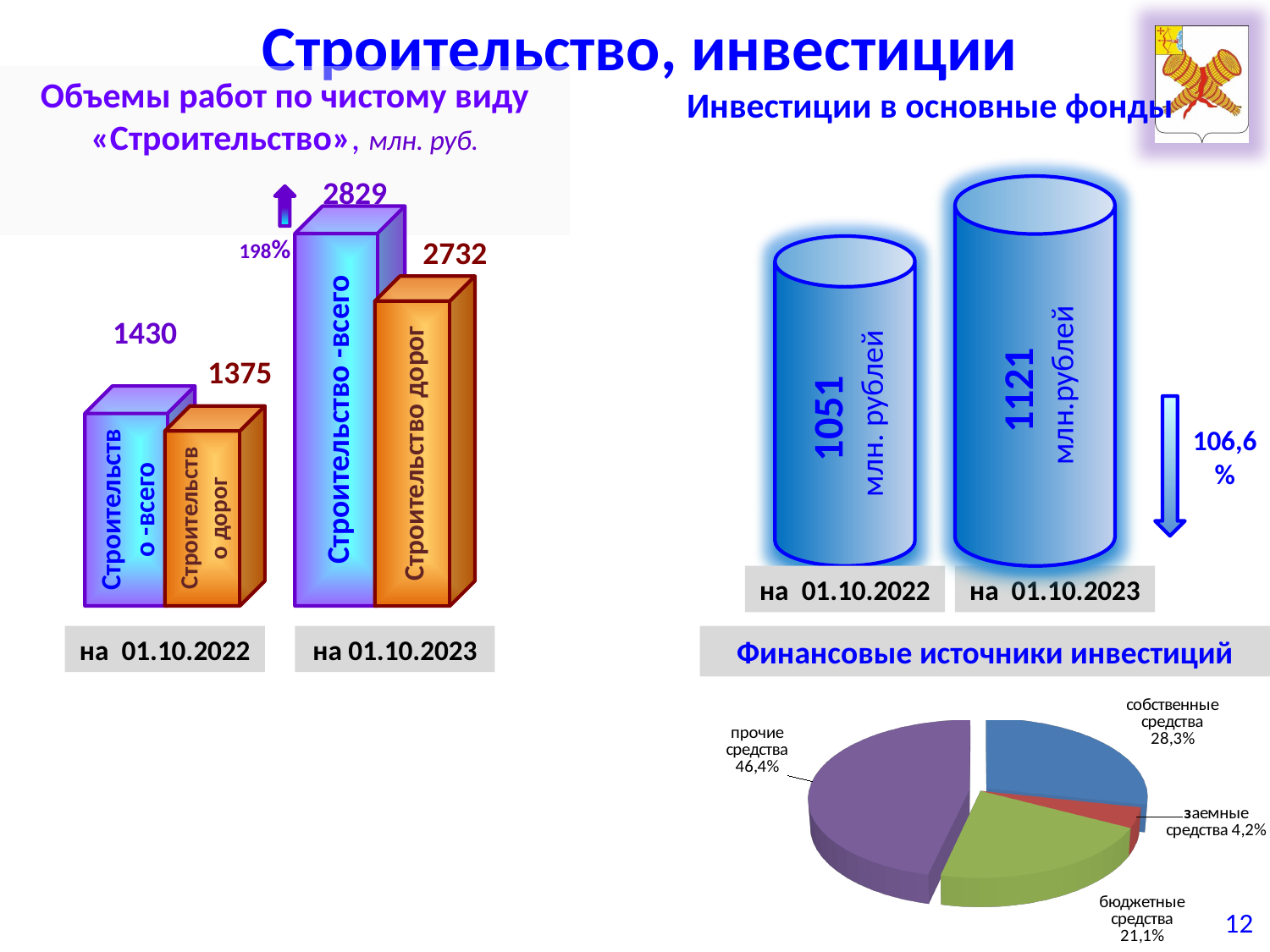
In the chart «Объемы работ по чистому виду «Строительство»», what is the value for «Строительство - всего» on 01.10.2023? 2829 In the chart «Инвестиции в основные фонды», what percentage is shown next to the arrow? 106,6% In the chart «Объемы работ по чистому виду «Строительство»», what is the difference between «Строительство - всего» and «Строительство дорог» on 01.10.2023? 97 In the chart «Объемы работ по чистому виду «Строительство»», what is the value for «Строительство дорог» on 01.10.2022? 1375 In the pie chart «Финансовые источники инвестиций», which source has the smallest share? заемные средства In the chart «Инвестиции в основные фонды», what is the difference between the values on 01.10.2023 and 01.10.2022? 70 In the pie chart «Финансовые источники инвестиций», what is the share of «прочие средства»? 46,4% In the chart «Объемы работ по чистому виду «Строительство»», do the values rise or fall from 01.10.2022 to 01.10.2023? rise In the chart «Объемы работ по чистому виду «Строительство»», which bar is the highest? Строительство - всего на 01.10.2023 In the chart «Инвестиции в основные фонды», what is the value on 01.10.2023? 1121 млн.рублей In the chart «Объемы работ по чистому виду «Строительство»», what growth percentage is shown next to the arrow? 198% How many slices does the pie chart «Финансовые источники инвестиций» have? 4